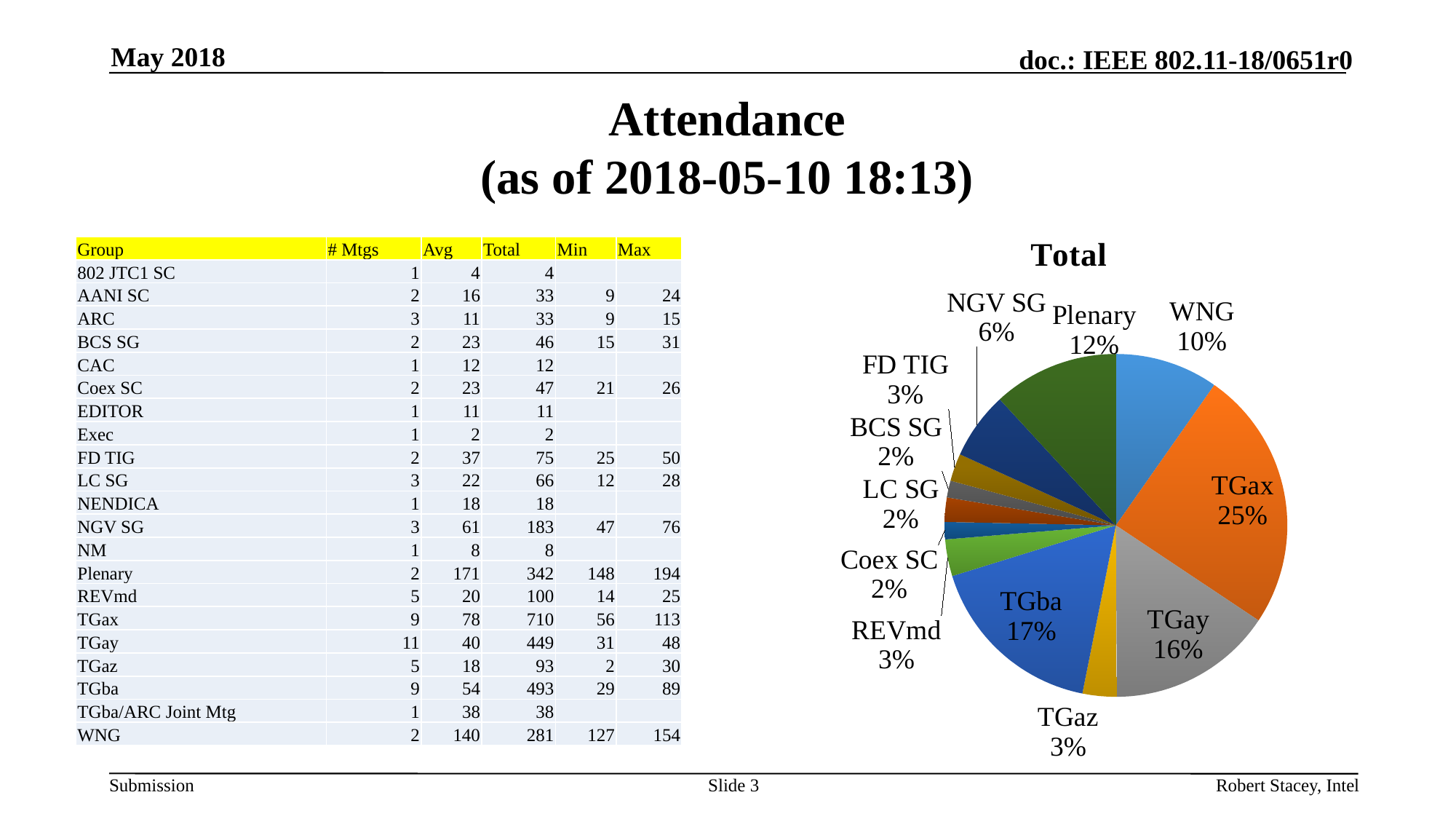
What is the title of the chart? Total What share of the pie does NGV SG have? 6% What is the difference in percentage points between the TGax share and the TGay share? 9 What share of the pie does Plenary have? 12% Which is larger, the share for TGay or the share for TGba? TGba What is the difference in percentage points between the Plenary share and the WNG share? 2 Which group has the largest slice of the pie? TGax What share of the pie does WNG have? 10% What type of chart is shown on the slide? pie chart